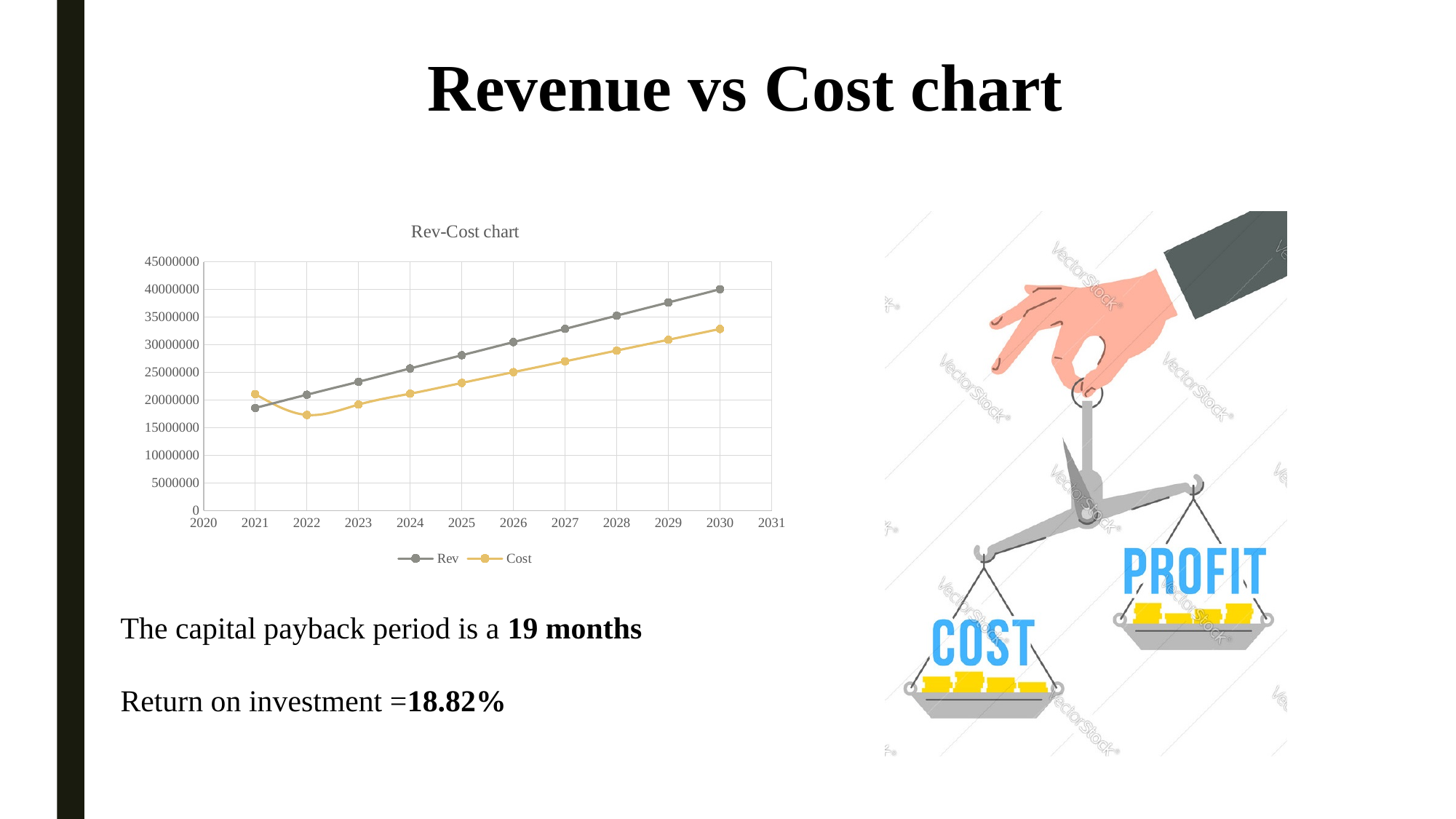
In which year is the Rev series highest in the Rev-Cost chart? 2030 Is the Rev value for 2030 greater or less than 35000000 in the Rev-Cost chart? greater What are the names of the two series in the Rev-Cost chart legend? Rev and Cost In which year is the Cost series lowest in the Rev-Cost chart? 2022 Does the Rev series rise or fall from 2021 to 2030 in the Rev-Cost chart? rise Is the Cost value for 2022 greater or less than 20000000 in the Rev-Cost chart? less What kind of chart is the Rev-Cost chart? line chart In 2030, which is larger in the Rev-Cost chart, Rev or Cost? Rev How many series does the legend of the Rev-Cost chart list? 2 In which year is the Rev series lowest in the Rev-Cost chart? 2021 How many years have data points plotted in the Rev-Cost chart? 10 In 2021, which is larger in the Rev-Cost chart, Rev or Cost? Cost